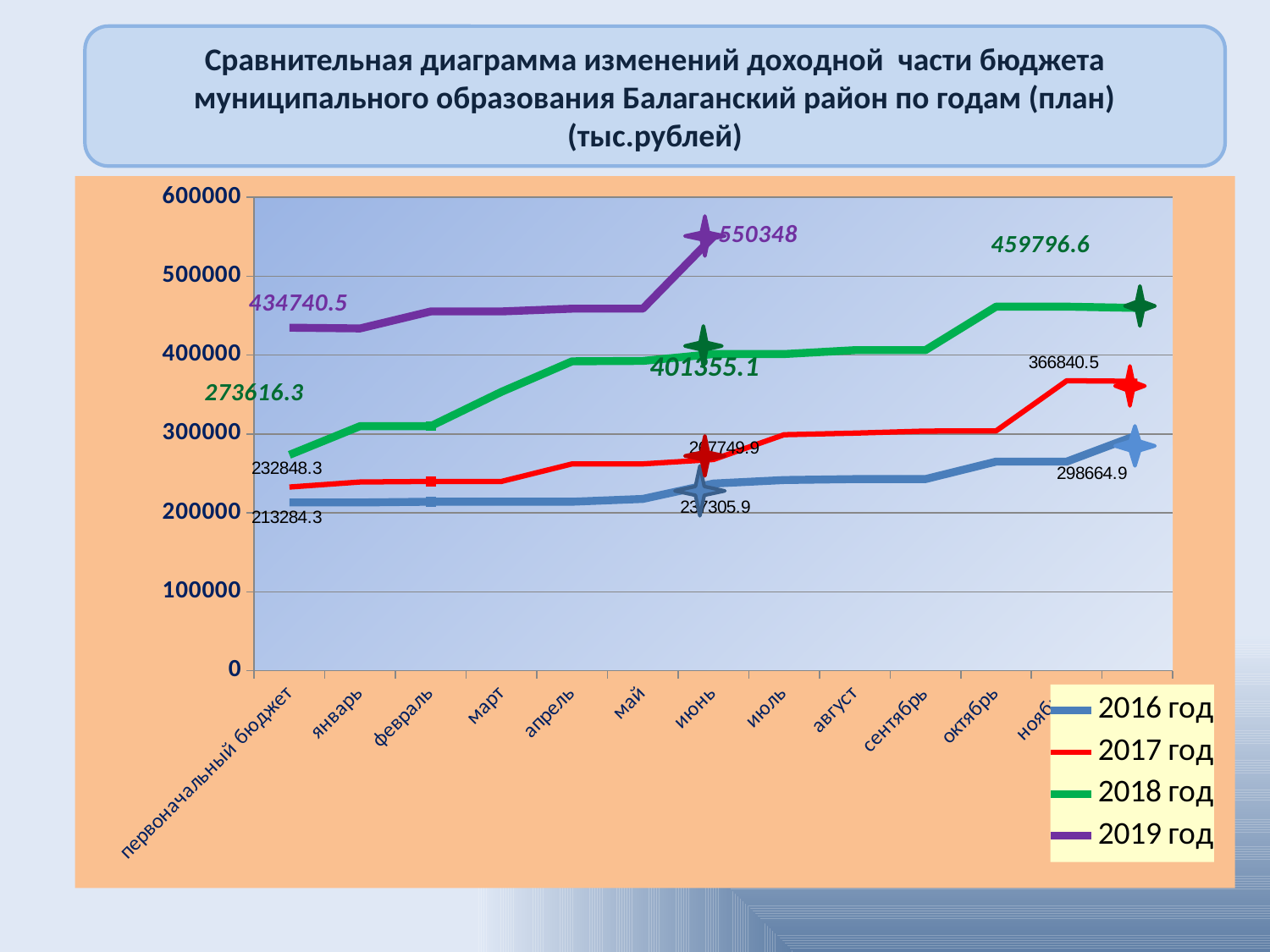
Does the 2019 год line rise or fall from первоначальный бюджет to июнь? rises What is the value for 2016 год at первоначальный бюджет? 213284.3 Is the value for 2016 год at май greater or less than 300000? less How many series does the legend list? 4 What is the value for 2017 год at июнь? 267749.9 What is the value for 2019 год at первоначальный бюджет? 434740.5 What is the value for 2019 год at июнь? 550348 Is the value for 2018 год at октябрь greater or less than 400000? greater What is the difference between the 2019 год and 2018 год values at июнь? 148992.9 What is the value for 2018 год at первоначальный бюджет? 273616.3 Which series has the highest value at первоначальный бюджет? 2019 год What kind of chart is shown on the slide? line chart